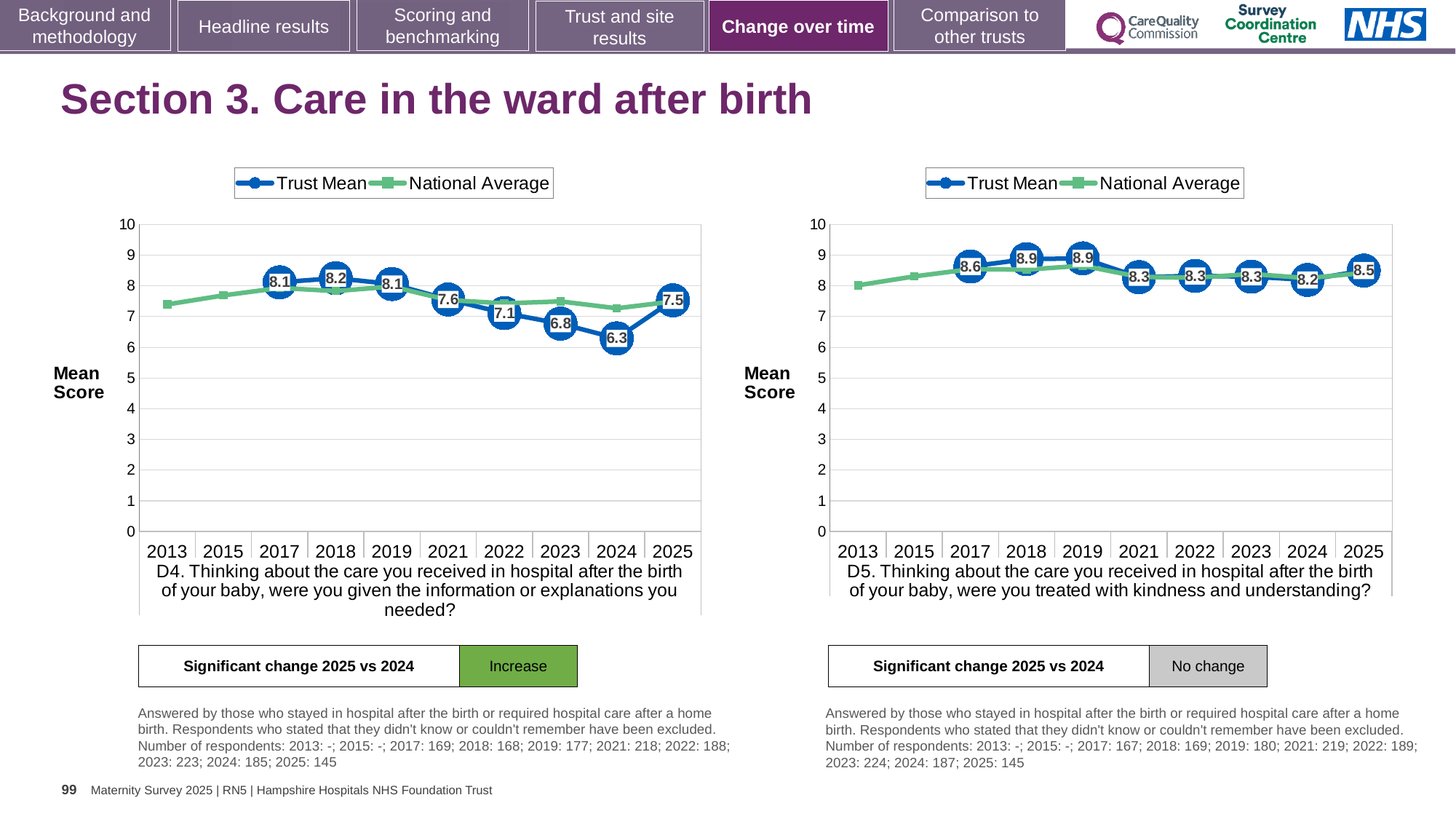
How many years are shown on the x axis of the D5 chart on the right? 10 In the D5 chart on the right, what is the Trust Mean for 2018? 8.9 In the D4 chart on the left, which year has the highest Trust Mean? 2018 In the D4 chart on the left, what is the difference between the Trust Mean in 2025 and in 2024? 1.2 In the D4 chart on the left, what is the Trust Mean for 2025? 7.5 In the D4 chart on the left, which year has the lowest Trust Mean? 2024 In the D5 chart on the right, what is the Trust Mean for 2024? 8.2 In the D4 chart on the left, what is the Trust Mean for 2024? 6.3 What type of chart is the D4 chart on the left? Line chart In the D4 chart on the left, is the National Average for 2013 greater or less than 8? less In the D5 chart on the right, how many series does the legend list? 2 In the D5 chart on the right, is the Trust Mean higher in 2017 or in 2025? 2017